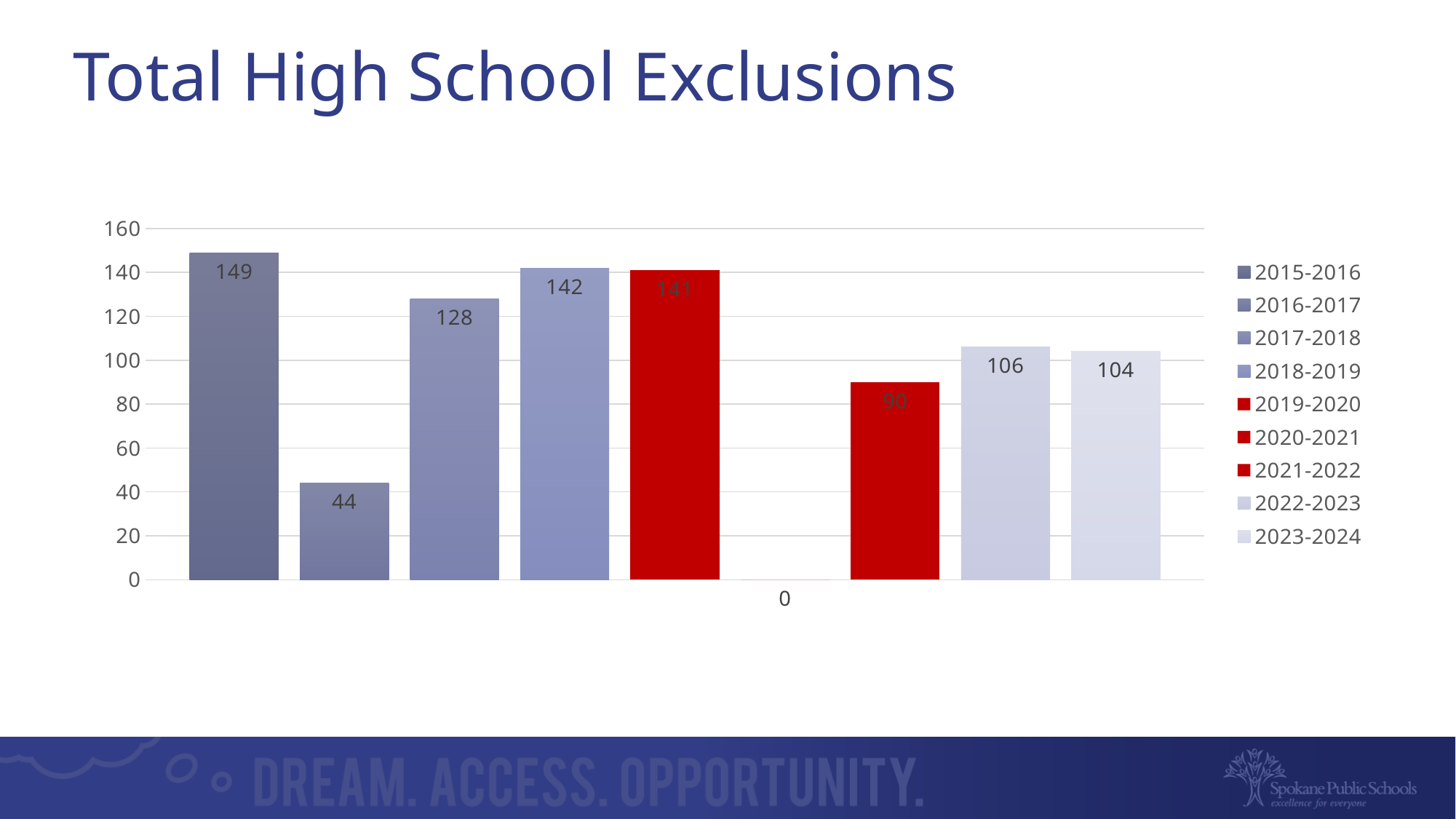
What is the difference between the values for 2015-2016 and 2016-2017? 105 What is the value for 2015-2016? 149 How many school years are plotted in the chart? 9 Which school year has the highest number of exclusions? 2015-2016 Which is larger, the value for 2017-2018 or the value for 2021-2022? 2017-2018 What is the value for 2023-2024? 104 What is the value for 2016-2017? 44 What type of chart is shown on the slide? Bar chart How many entries does the legend list? 9 What is the value for 2021-2022? 90 What is the difference between the values for 2022-2023 and 2023-2024? 2 Which school year has the lowest number of exclusions? 2020-2021